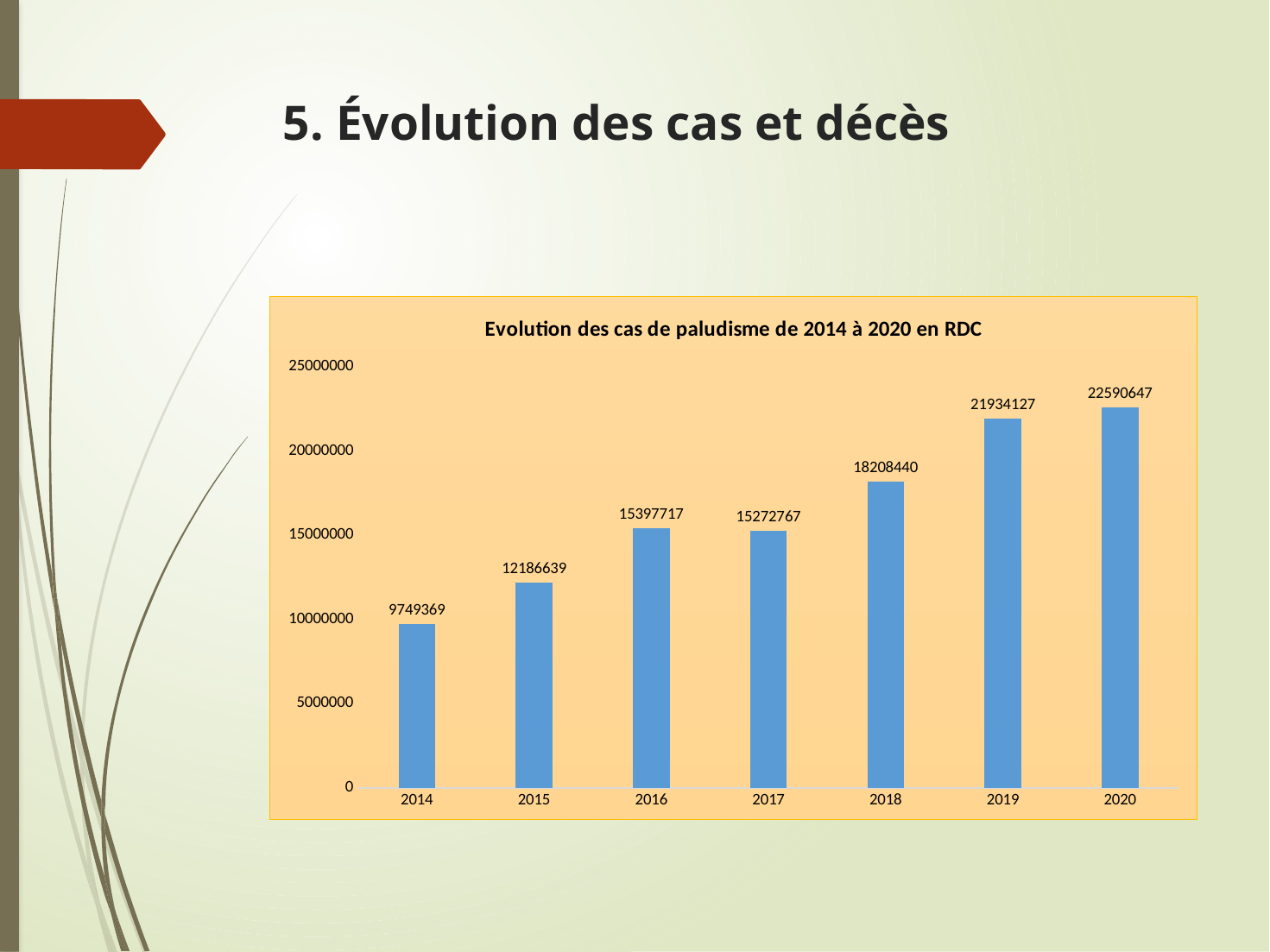
What is the difference between the values for 2020 and 2019? 656520 Which is larger, the value for 2016 or the value for 2017? 2016 What kind of chart is this? bar chart What is the value for 2020? 22590647 What is the value for 2014? 9749369 What is the difference between the values for 2015 and 2014? 2437270 How many years are shown on the x axis? 7 Which year has the highest value? 2020 Which year has the lowest value? 2014 Is the value for 2019 greater or less than 20000000? greater What is the title of the chart? Evolution des cas de paludisme de 2014 à 2020 en RDC What is the value for 2018? 18208440